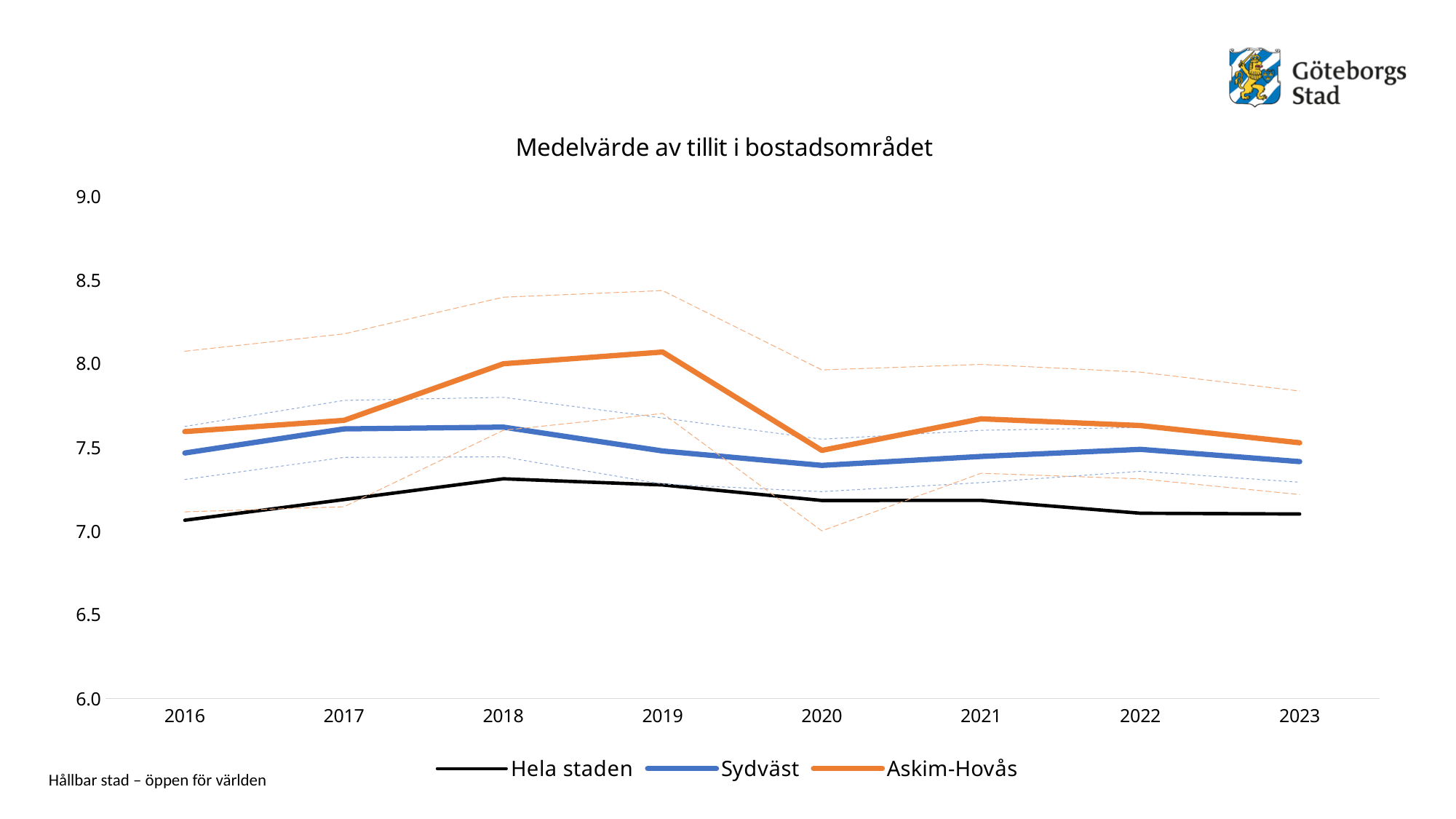
Which series is drawn in orange? Askim-Hovås Is the value for Hela staden in 2018 greater or less than 7.5? less What kind of chart is shown on the slide? Line chart In which year does the Askim-Hovås line reach its highest value? 2019 In which year does the Askim-Hovås line reach its lowest value? 2020 How many series does the legend list? 3 What is the title of the chart? Medelvärde av tillit i bostadsområdet In 2019, which series has the higher value, Askim-Hovås or Hela staden? Askim-Hovås How many years are shown along the x axis? 8 In which year does the Hela staden line reach its highest value? 2018 Is the value for Askim-Hovås in 2016 greater or less than 7.5? greater Does the Hela staden line rise or fall from 2018 to 2023? Fall